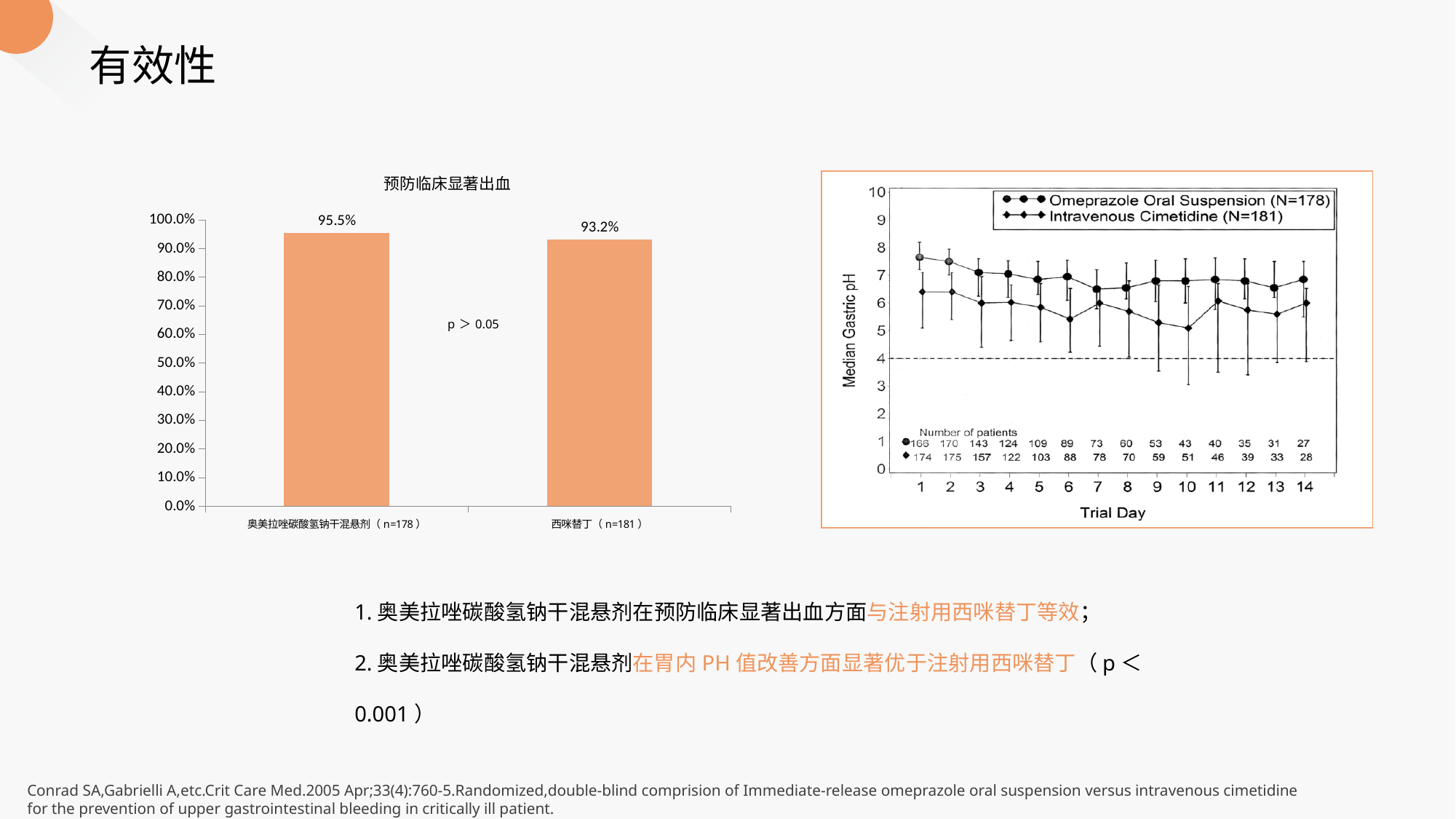
In the Median Gastric pH chart on the right, is the value for Omeprazole Oral Suspension on Trial Day 1 greater or less than 7? greater In the bar chart titled 预防临床显著出血, which category has the higher value? 奥美拉唑碳酸氢钠干混悬剂（n=178） In the Median Gastric pH chart on the right, what is the number of patients for Omeprazole Oral Suspension on Trial Day 14? 27 In the Median Gastric pH chart on the right, how many trial days are shown on the x axis? 14 In the bar chart titled 预防临床显著出血, how many bars are plotted? 2 In the Median Gastric pH chart on the right, is the value for Intravenous Cimetidine on Trial Day 10 greater or less than 6? less In the bar chart titled 预防临床显著出血, what is the value for 西咪替丁（n=181）? 93.2% In the bar chart titled 预防临床显著出血, what is the value for 奥美拉唑碳酸氢钠干混悬剂（n=178）? 95.5% What kind of chart is the chart on the left of the slide? Bar chart In the Median Gastric pH chart on the right, how many series does the legend list? 2 In the bar chart titled 预防临床显著出血, what p-value annotation is shown between the bars? p ＞ 0.05 In the bar chart titled 预防临床显著出血, what is the difference between the two bars? 2.3%